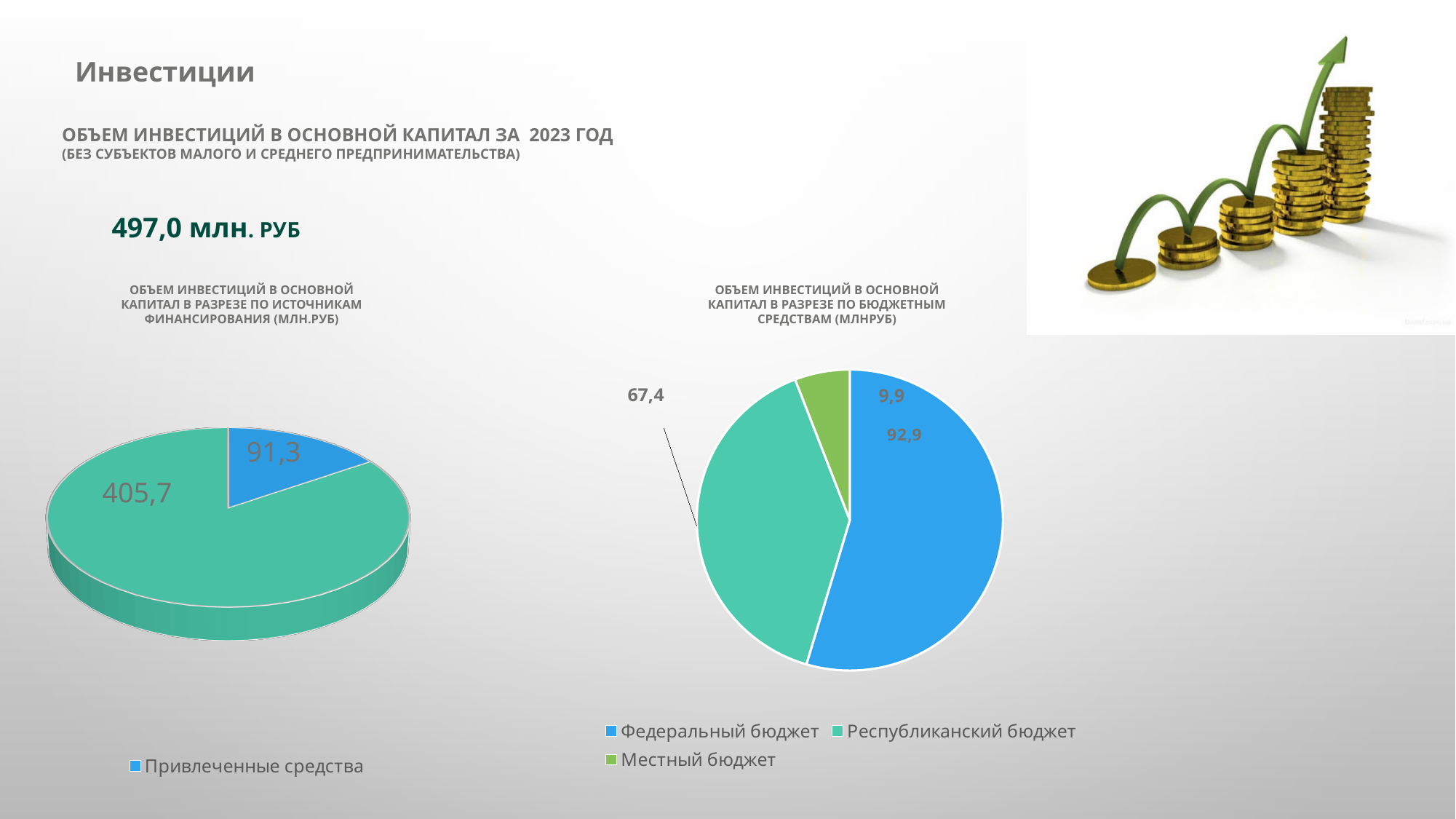
What kind of chart is the chart titled 'Объем инвестиций в основной капитал в разрезе по бюджетным средствам (млнруб)'? pie chart In the chart 'Объем инвестиций в основной капитал в разрезе по бюджетным средствам', what is the value for Республиканский бюджет? 67,4 In the chart 'Объем инвестиций в основной капитал в разрезе по бюджетным средствам', which is larger: Республиканский бюджет or Местный бюджет? Республиканский бюджет In the chart 'Объем инвестиций в основной капитал в разрезе по источникам финансирования (млн.руб)', what colour is the slice for Привлеченные средства? blue In the chart 'Объем инвестиций в основной капитал в разрезе по источникам финансирования (млн.руб)', what value is shown on the large teal slice? 405,7 In the chart 'Объем инвестиций в основной капитал в разрезе по бюджетным средствам', which category has the largest slice? Федеральный бюджет In the chart 'Объем инвестиций в основной капитал в разрезе по бюджетным средствам', what is the difference between Федеральный бюджет and Республиканский бюджет? 25,5 In the chart 'Объем инвестиций в основной капитал в разрезе по бюджетным средствам', which category has the smallest slice? Местный бюджет In the chart 'Объем инвестиций в основной капитал в разрезе по бюджетным средствам', what is the value for Федеральный бюджет? 92,9 In the chart 'Объем инвестиций в основной капитал в разрезе по бюджетным средствам', what is the value for Местный бюджет? 9,9 In the chart 'Объем инвестиций в основной капитал в разрезе по бюджетным средствам', how many categories does the legend list? 3 In the chart 'Объем инвестиций в основной капитал в разрезе по источникам финансирования (млн.руб)', what is the value for Привлеченные средства? 91,3